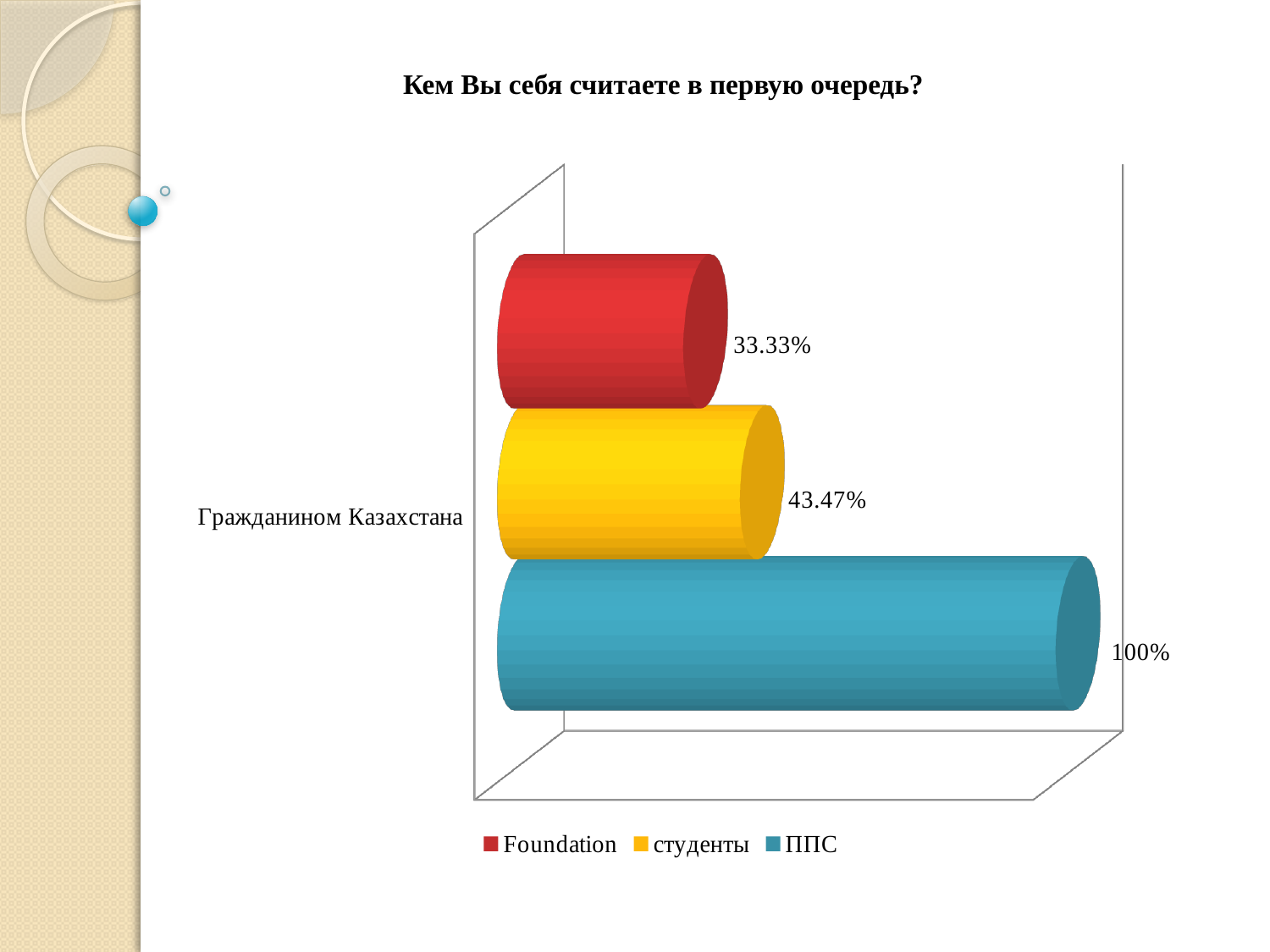
How many series does the legend list? 3 What is the value for ППС for the category Гражданином Казахстана? 100% What kind of chart is shown on the slide? bar chart Which is larger, the value for студенты or the value for Foundation? студенты Which series has the lowest value? Foundation How many categories are shown on the chart? 1 What is the difference between the values for студенты and Foundation? 10.14% Which series has the highest value? ППС What is the value for студенты for the category Гражданином Казахстана? 43.47% What is the value for Foundation for the category Гражданином Казахстана? 33.33% What is the title of the chart? Кем Вы себя считаете в первую очередь? What is the difference between the values for ППС and студенты? 56.53%